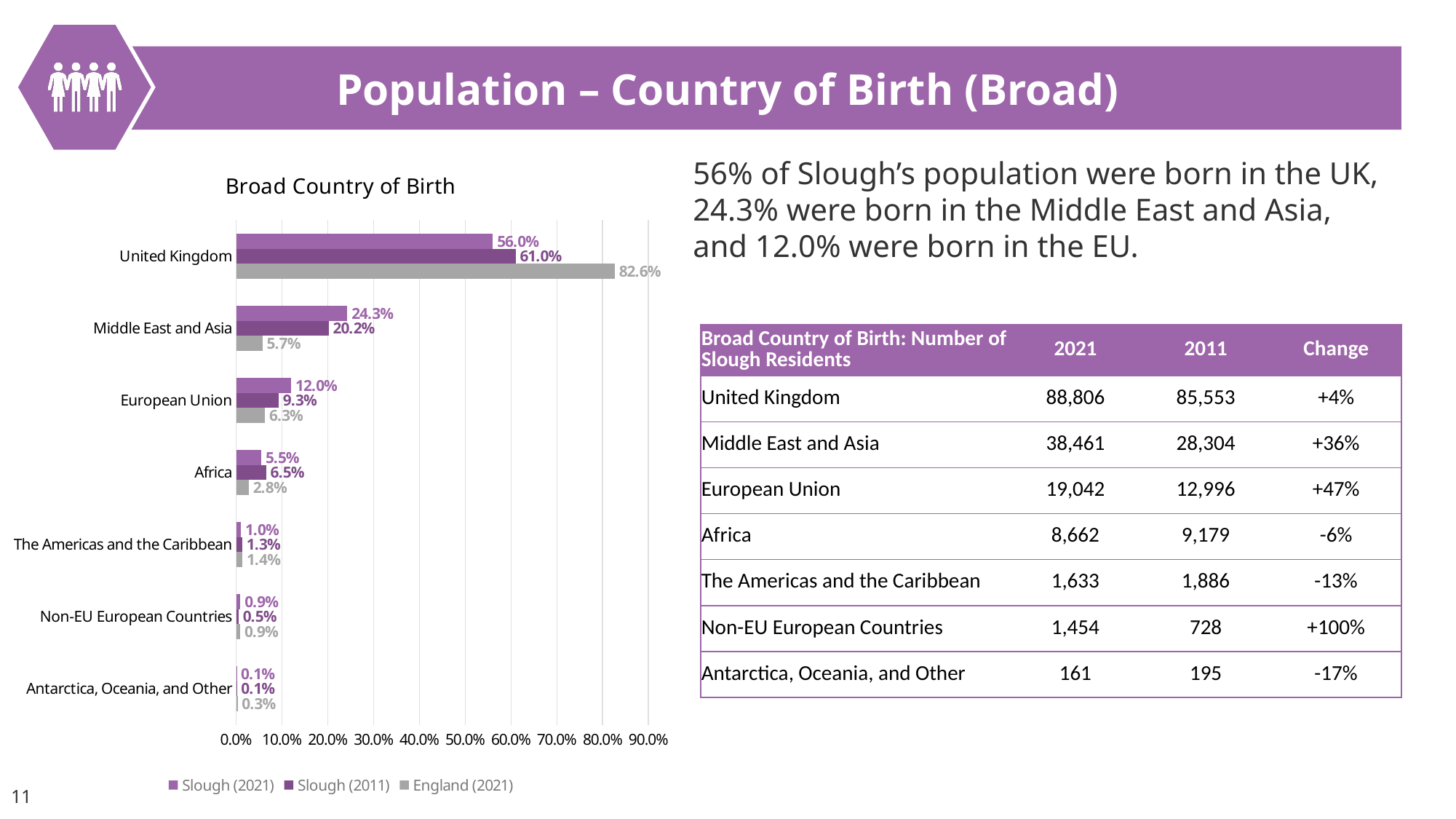
What are the three series listed in the legend of the Broad Country of Birth chart? Slough (2021), Slough (2011), England (2021) Which category has the highest Slough (2021) value in the Broad Country of Birth chart? United Kingdom Which category has the lowest England (2021) value in the Broad Country of Birth chart? Antarctica, Oceania, and Other What is the Slough (2021) value for United Kingdom in the Broad Country of Birth chart? 56.0% How many series does the legend of the Broad Country of Birth chart list? 3 What type of chart is the Broad Country of Birth chart? Bar chart What is the England (2021) value for Middle East and Asia in the Broad Country of Birth chart? 5.7% Is the England (2021) value for United Kingdom greater or less than 80.0% in the Broad Country of Birth chart? greater For Africa, which is larger in the Broad Country of Birth chart: the Slough (2021) value or the Slough (2011) value? Slough (2011) What is the Slough (2011) value for European Union in the Broad Country of Birth chart? 9.3% How many categories are shown in the Broad Country of Birth chart? 7 What is the difference between the England (2021) and Slough (2021) values for United Kingdom in the Broad Country of Birth chart? 26.6%